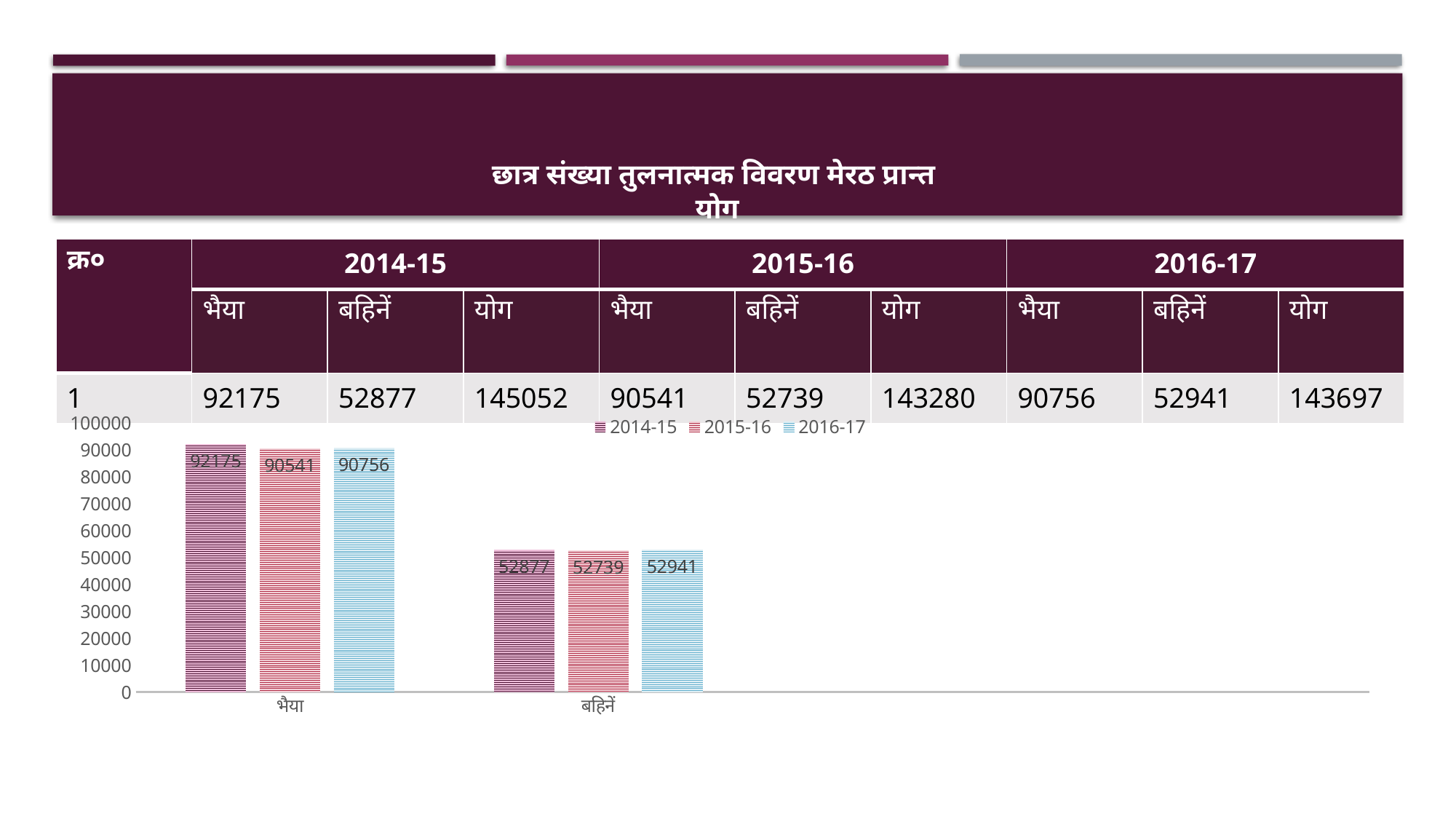
Which category has the highest value in the 2016-17 series? भैया What is the value for भैया in the 2015-16 series? 90541 Is the value for भैया in the 2016-17 series greater or less than 80000? greater How many categories are shown on the x axis of the chart? 2 How many series does the chart legend list? 3 What is the value for बहिनें in the 2016-17 series? 52941 Which series is shown in blue in the chart legend? 2016-17 Which category has the lowest value in the 2014-15 series? बहिनें What type of chart is shown on the slide? bar chart What is the value for बहिनें in the 2015-16 series? 52739 What is the value for भैया in the 2014-15 series? 92175 What is the difference between the 2014-15 values for भैया and बहिनें? 39298